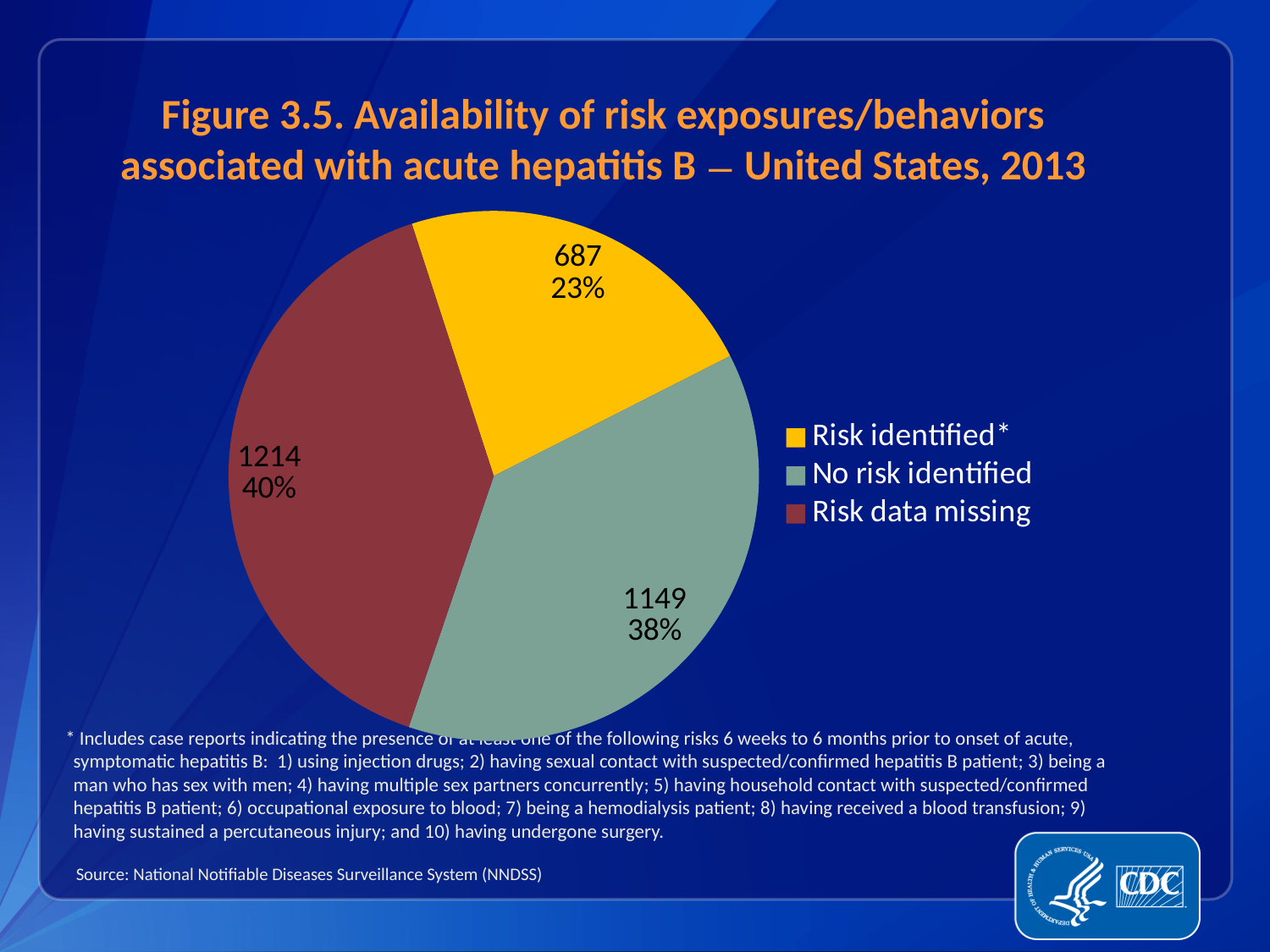
How many cases are in the 'Risk data missing' slice? 1214 What colour is the 'No risk identified' slice? grey-green What is the total number of cases across all three slices? 3050 How many categories does the pie chart show? 3 Which has more cases, 'Risk identified*' or 'No risk identified'? No risk identified What type of chart is shown on the slide? pie chart Which category has the smallest slice of the pie? Risk identified* What percentage of the pie is 'Risk data missing'? 40% What percentage of the pie is 'No risk identified'? 38% How many cases are in the 'Risk identified*' slice? 687 Which category has the largest slice of the pie? Risk data missing What is the difference in cases between 'Risk data missing' and 'No risk identified'? 65